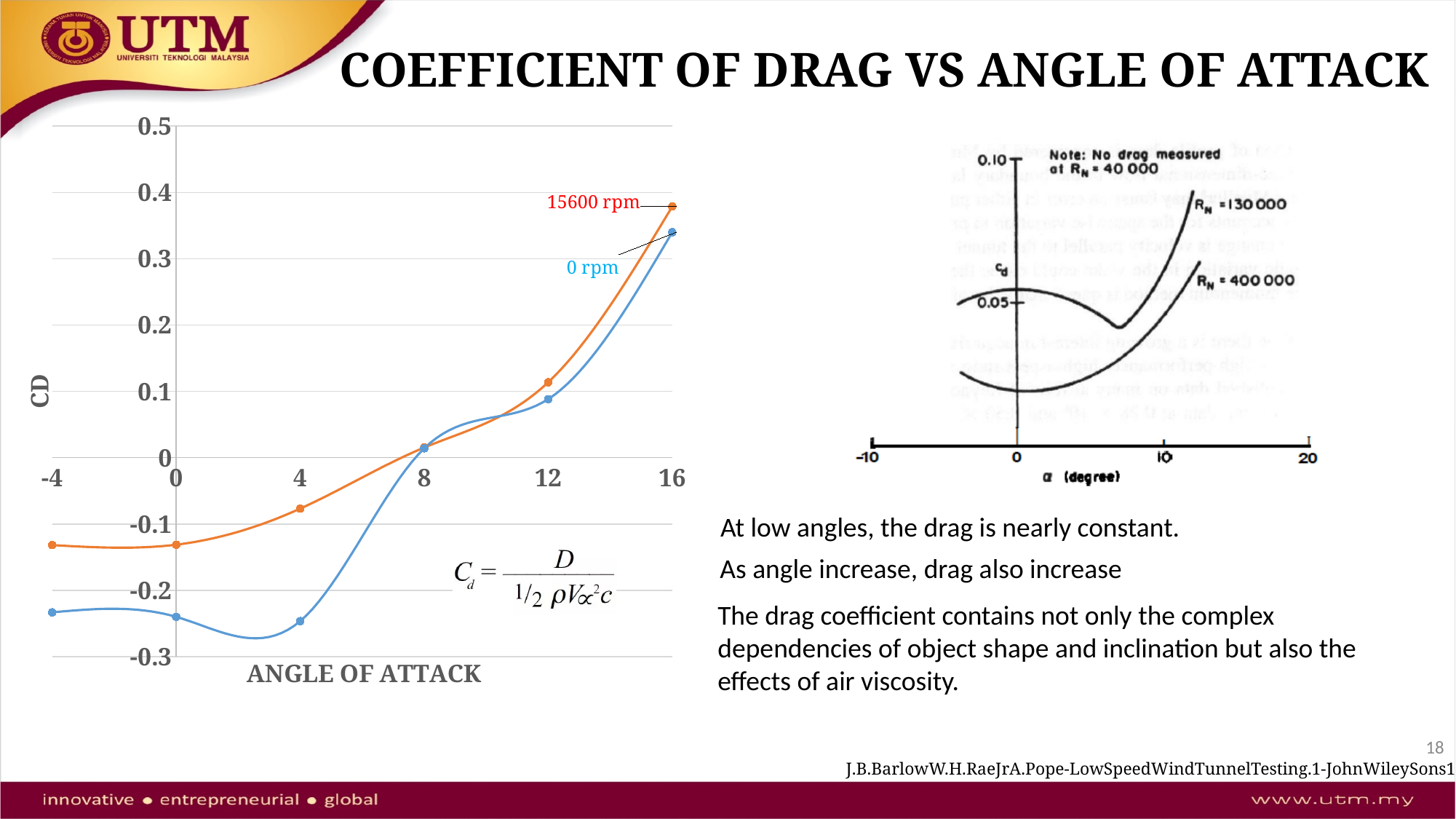
How many data points are plotted for the 0 rpm series on the left chart? 6 What is the x-axis title of the left chart? ANGLE OF ATTACK On the left chart, is the CD value for 15600 rpm at an angle of attack of 0 greater or less than -0.2? greater On the left chart, is the CD value for 0 rpm at an angle of attack of -4 greater or less than -0.2? less What kind of chart is the 'Coefficient of Drag vs Angle of Attack' chart on the left of the slide? line chart On the left chart, is the CD value for 0 rpm at an angle of attack of 4 greater or less than -0.2? less On the left chart, at which angle of attack does the 15600 rpm series reach its highest CD? 16 How many data series are plotted on the left chart? 2 On the left chart, does the CD for the 15600 rpm series rise or fall as the angle of attack increases from 0 to 16? rise What are the two series labelled on the left chart? 15600 rpm and 0 rpm On the left chart, which series has the higher CD at an angle of attack of 16, 15600 rpm or 0 rpm? 15600 rpm